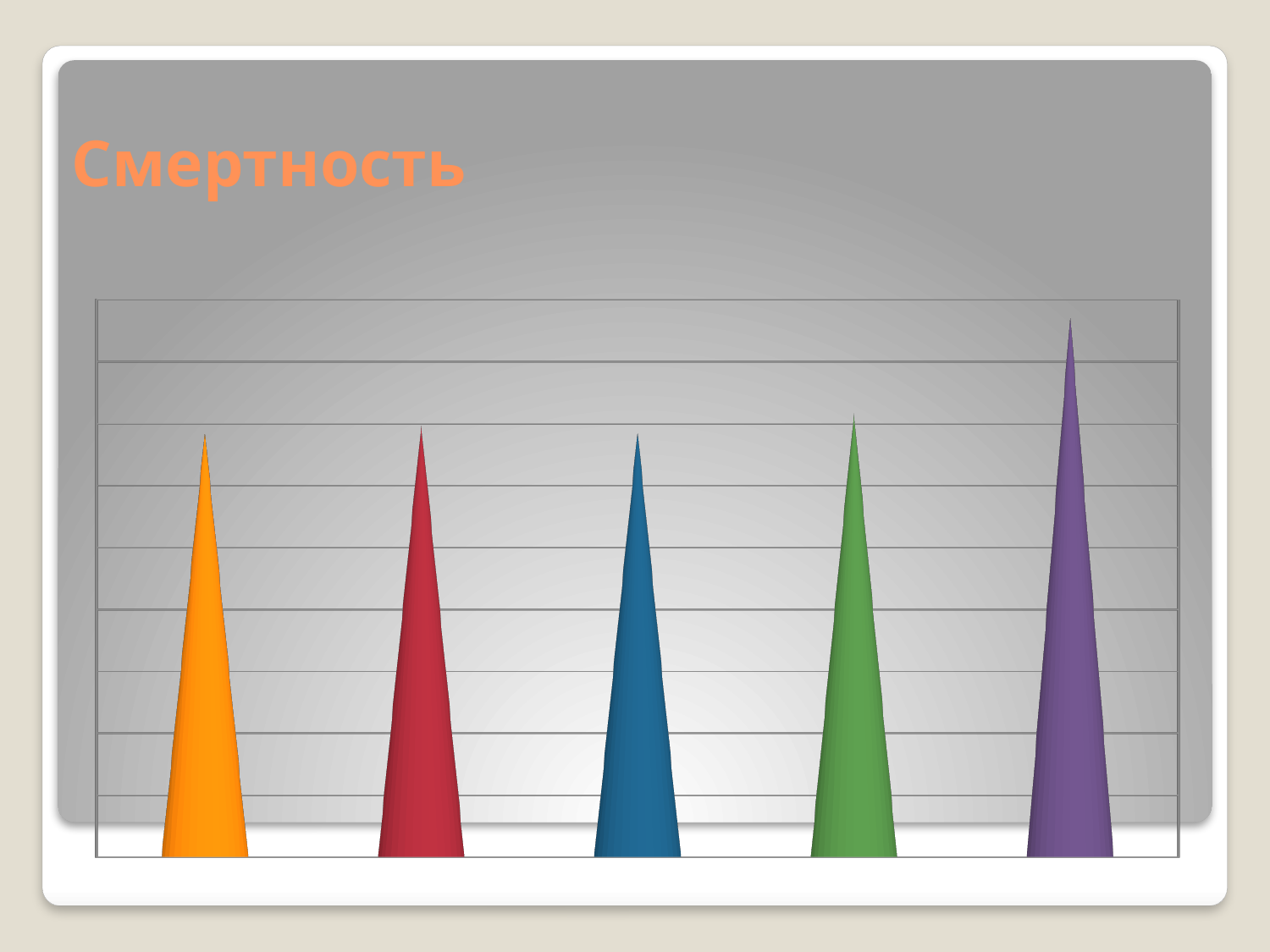
Which is taller, the rightmost bar or the middle (blue) bar? the rightmost bar What kind of chart is shown on the slide? bar chart Which bar is the tallest in the chart? the rightmost (purple) bar How many bars does the chart contain? 5 Which is taller, the purple bar or the orange bar? the purple bar What is the title shown on the slide above the chart? Смертность What colour is the leftmost bar in the chart? orange